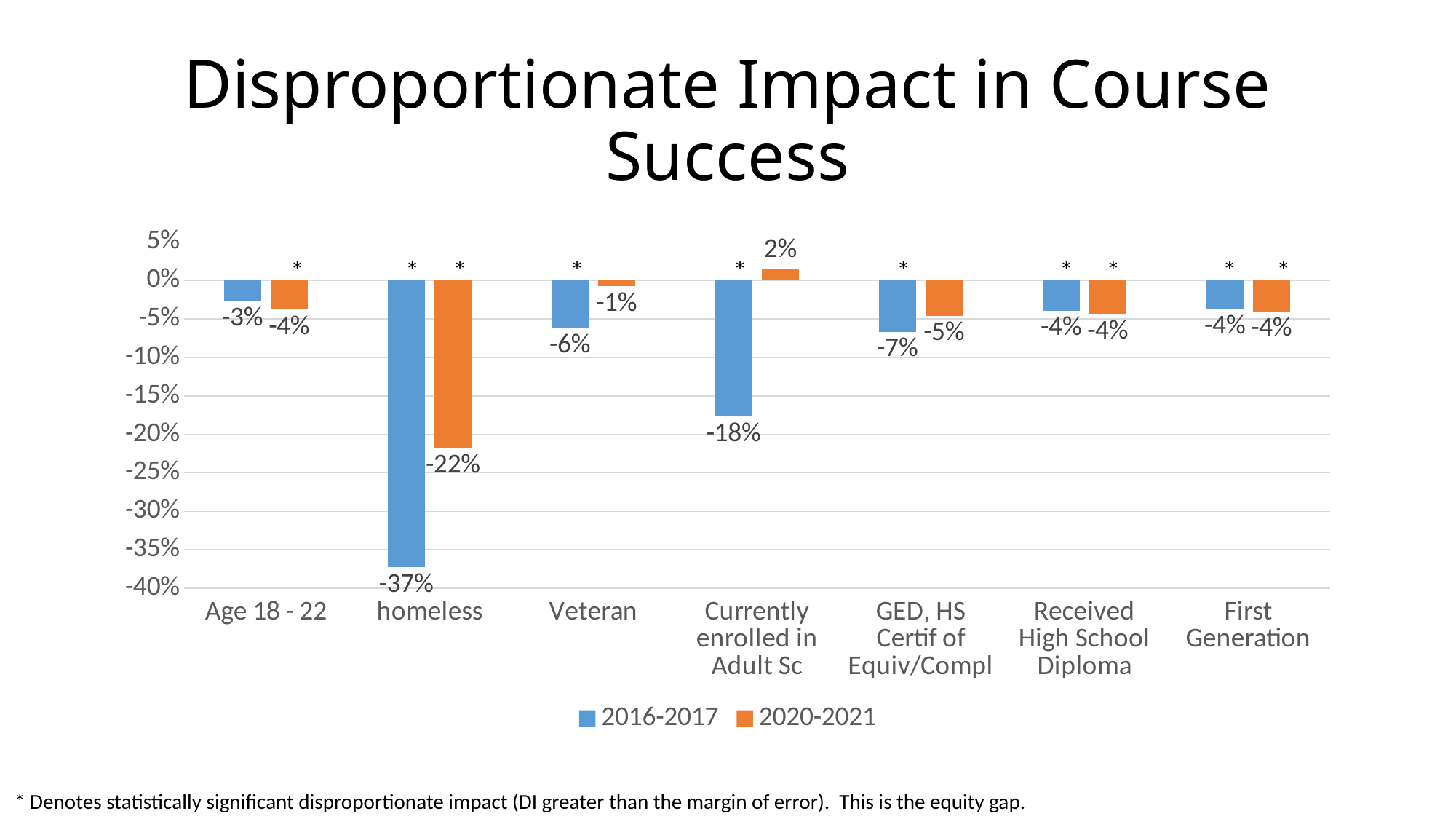
What is the 2020-2021 value for GED, HS Certif of Equiv/Compl? -5% Which category has the lowest 2016-2017 value? homeless How many categories are shown on the x axis? 7 How many series does the legend list? 2 What is the 2016-2017 value for homeless? -37% What kind of chart is shown on the slide? Bar chart What is the 2016-2017 value for Veteran? -6% What is the title of the chart? Disproportionate Impact in Course Success Which is larger for Age 18 - 22, the 2016-2017 value or the 2020-2021 value? 2016-2017 Which category has the highest 2020-2021 value? Currently enrolled in Adult Sc What is the difference between the 2016-2017 and 2020-2021 values for homeless? 15 percentage points What is the 2020-2021 value for Currently enrolled in Adult Sc? 2%